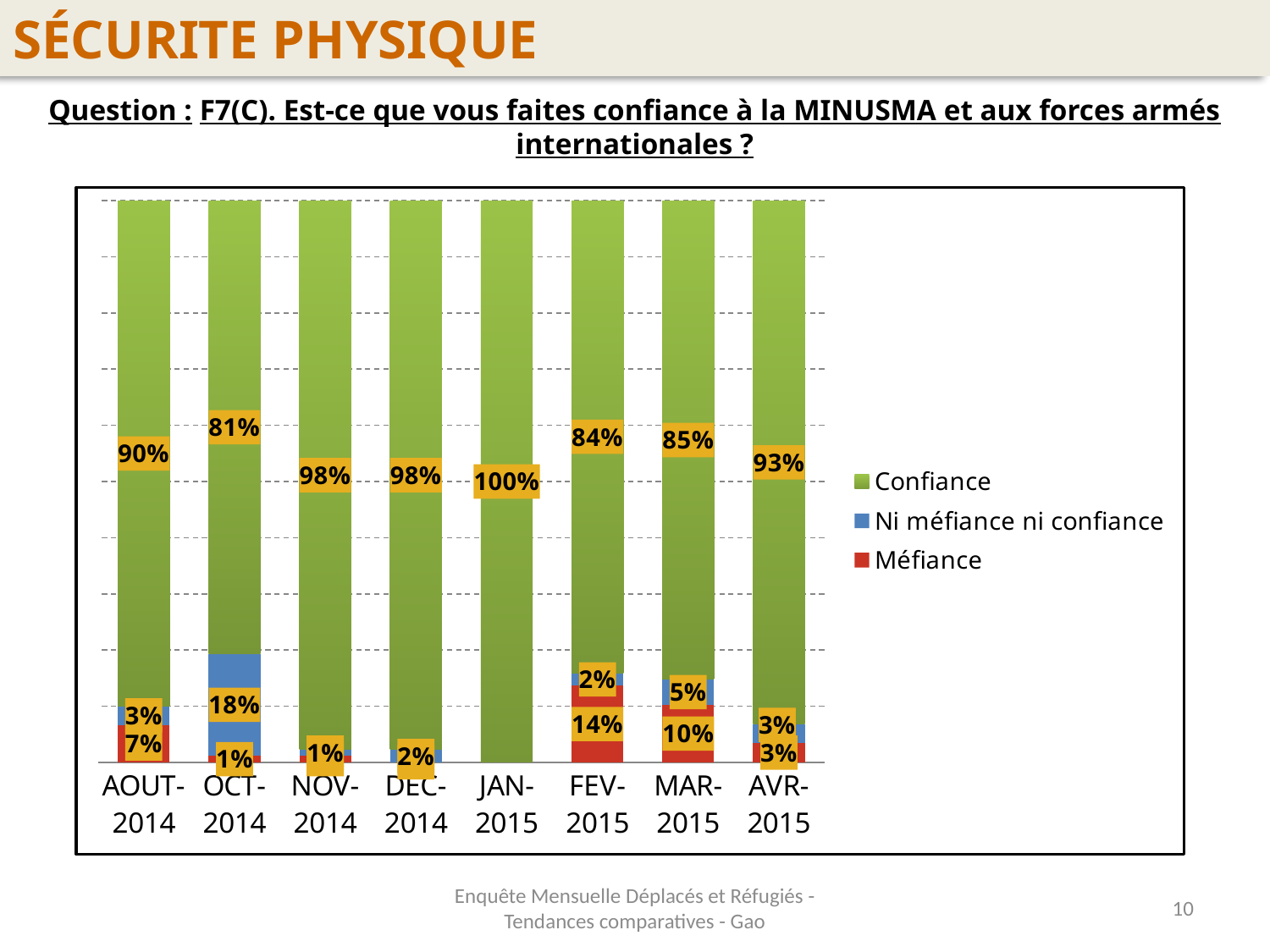
How many months are shown on the x axis? 8 What is the 'Ni méfiance ni confiance' value for OCT-2014? 18% Which month has the lowest Confiance value? OCT-2014 What colour represents the Confiance series? Green Which month has the larger Méfiance value, AOUT-2014 or MAR-2015? MAR-2015 Which month has the highest Confiance value? JAN-2015 What is the difference between the Confiance values for MAR-2015 and FEV-2015? 1 percentage point How many series does the legend list? 3 What is the Confiance value for AVR-2015? 93% What is the Méfiance value for FEV-2015? 14% What is the Confiance value for AOUT-2014? 90% What kind of chart is shown on the slide? Stacked bar chart